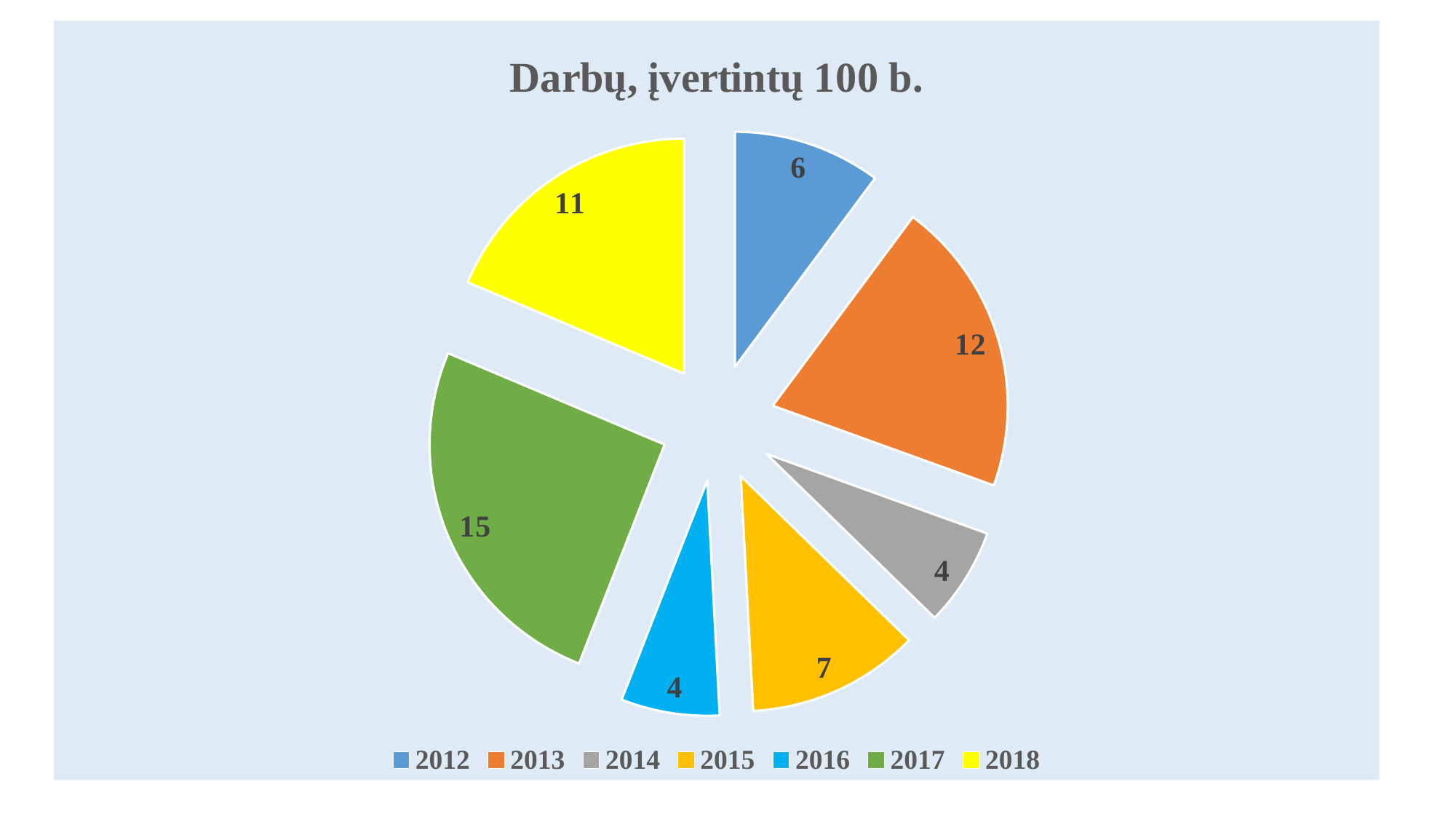
What kind of chart is shown on the slide? Pie chart What is the value for 2012 in the pie chart? 6 What is the title of the chart? Darbų, įvertintų 100 b. What is the value for 2017 in the pie chart? 15 What is the difference between the values for 2017 and 2013? 3 Which year has the largest slice in the pie chart? 2017 What is the value for 2013 in the pie chart? 12 What is the difference between the values for 2018 and 2012? 5 How many slices does the pie chart have? 7 What is the value for 2018 in the pie chart? 11 Which is larger, the value for 2015 or the value for 2016? 2015 Which year is shown in yellow in the pie chart? 2018